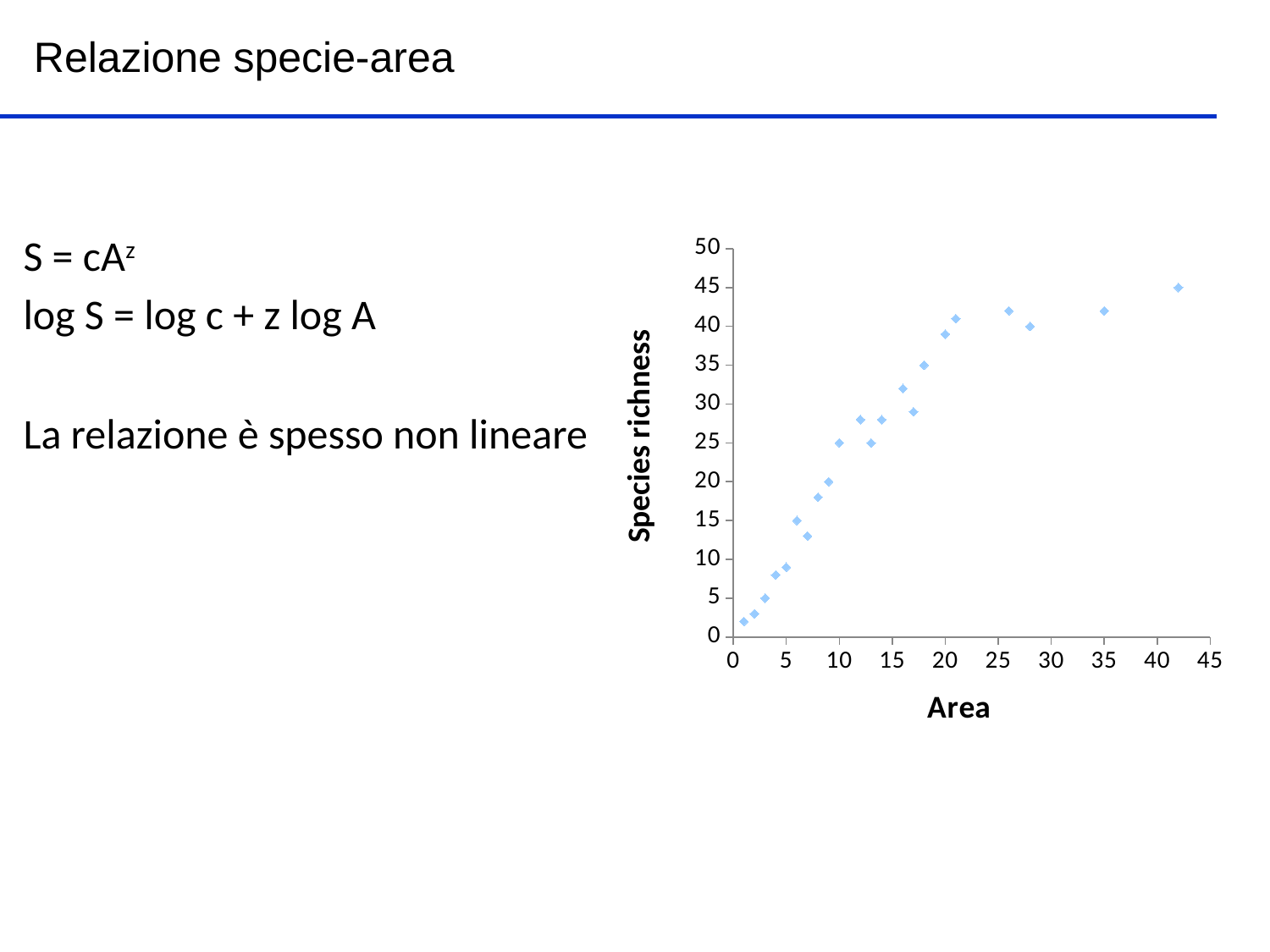
Is the species richness value for the point at area 35 greater or less than 40? greater Is the species richness value for the point at area 16 greater or less than 30? greater Is the species richness value for the point at area 1 greater or less than 5? less What kind of chart is shown on the slide? scatter chart Do the species richness values generally rise or fall as area increases along the x axis? rise What is the title of the y axis of the chart? Species richness What is the title of the x axis of the chart? Area How many data points are plotted on the chart? 22 Which point has the highest species richness: the one at area 42 or the one at area 1? the one at area 42